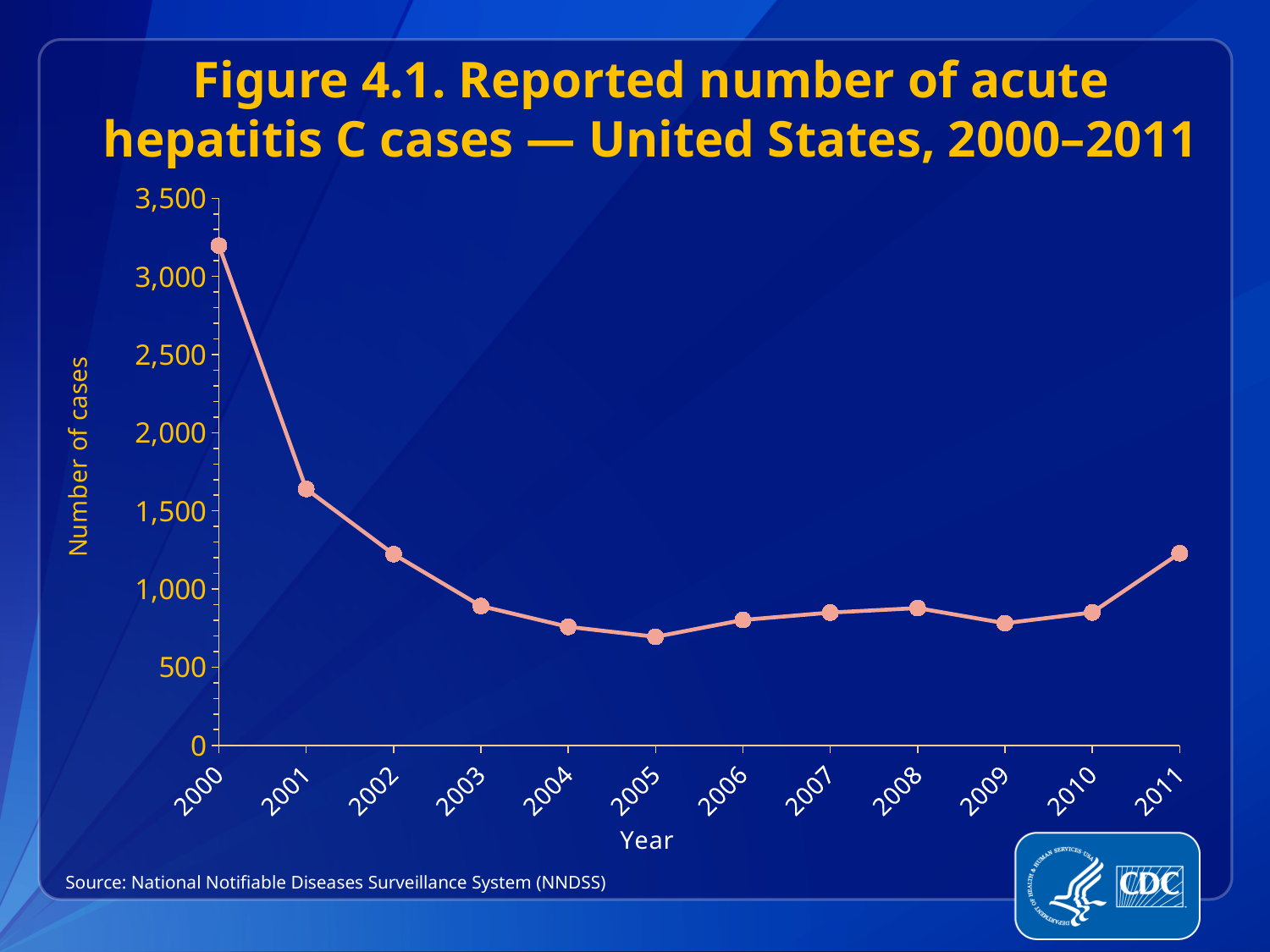
What is the label on the vertical axis of the chart? Number of cases Which year had more reported cases, 2000 or 2011? 2000 Is the number of cases in 2000 greater or less than 3,000? greater How many years (data points) are plotted on the chart? 12 Which year has the highest reported number of acute hepatitis C cases? 2000 Is the number of cases in 2001 greater or less than 1,500? greater Do the reported cases rise or fall from 2000 to 2005? fall Which year has the lowest reported number of acute hepatitis C cases? 2005 Is the number of cases in 2003 greater or less than 1,000? less What kind of chart is shown on the slide? line chart Which year had more reported cases, 2001 or 2002? 2001